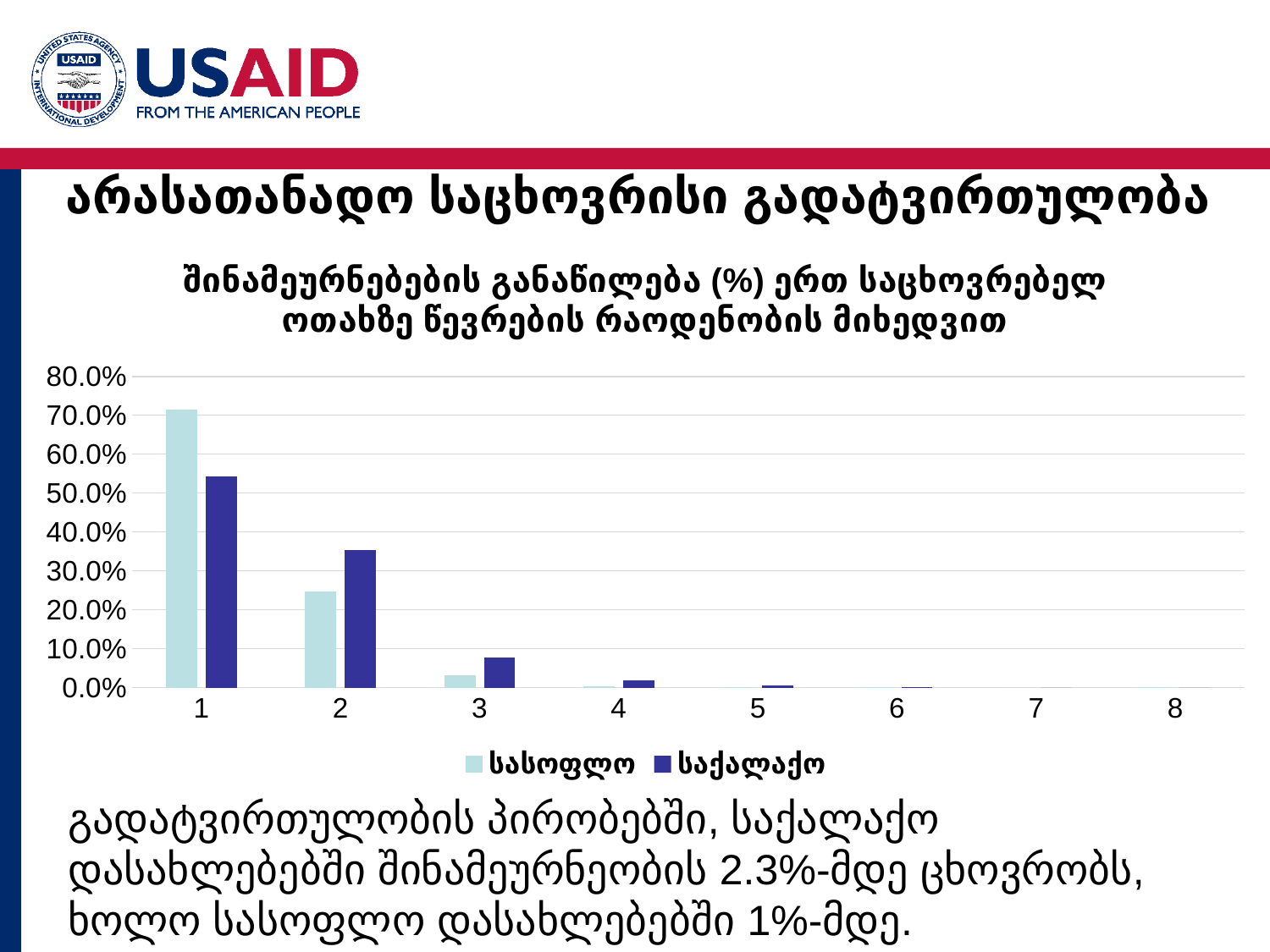
How many categories are shown on the x axis of the chart? 8 Do the values for the საქალაქო series rise or fall as the category number increases from 1 to 8? fall Which category has the highest value for the სასოფლო series? 1 Is the value for საქალაქო in category 3 greater or less than 10.0%? less For category 1, which series has the larger value, სასოფლო or საქალაქო? სასოფლო Is the value for სასოფლო in category 1 greater or less than 60.0%? greater For category 2, which series has the larger value, სასოფლო or საქალაქო? საქალაქო Which series is shown in light blue in the chart legend? სასოფლო What kind of chart is shown on the slide? bar chart How many series does the chart legend list? 2 Which category has the highest value for the საქალაქო series? 1 Is the value for საქალაქო in category 2 greater or less than 40.0%? less